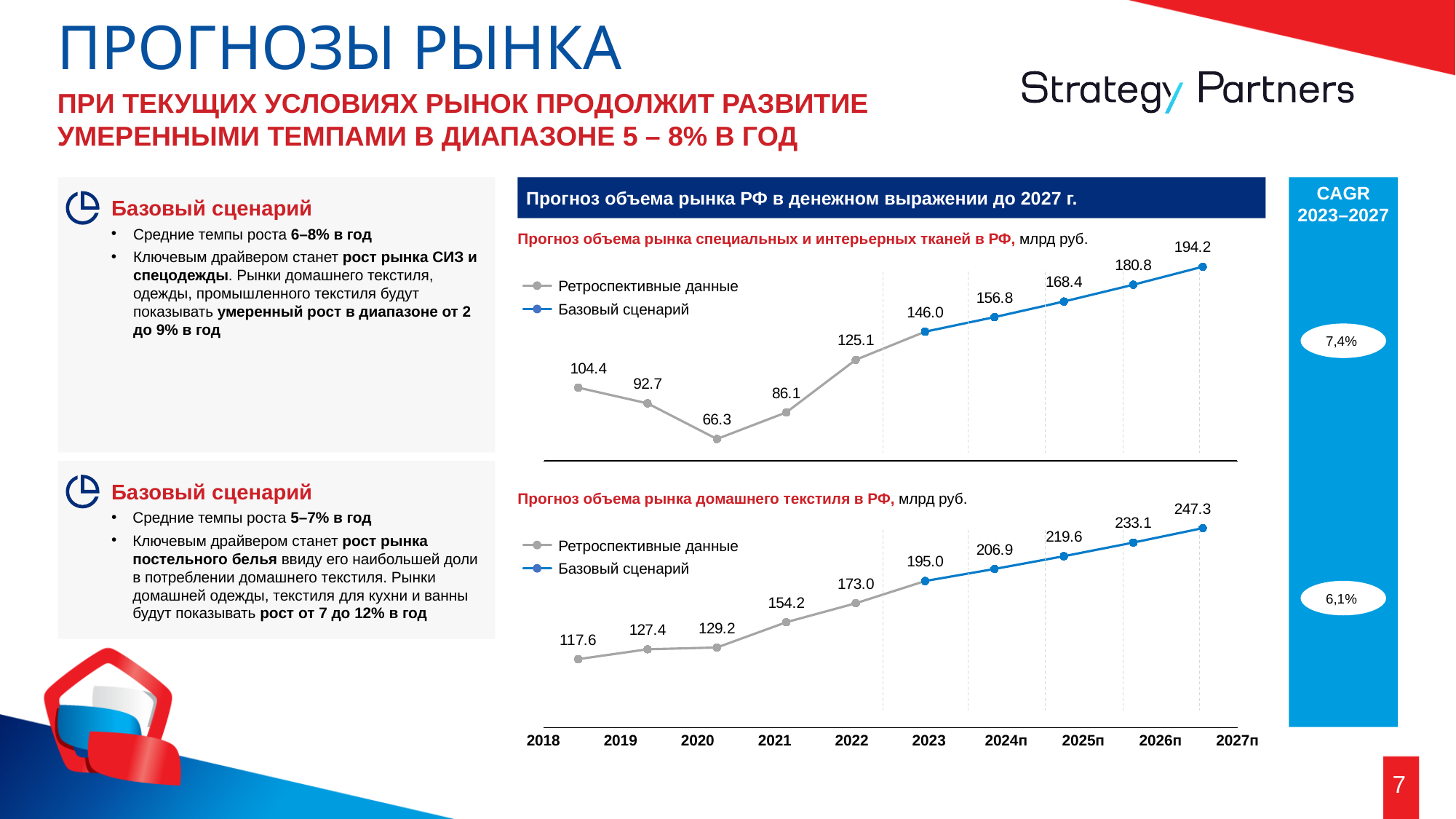
Which is larger: the 2022 value in the chart 'Прогноз объема рынка домашнего текстиля в РФ' or the 2022 value in the chart 'Прогноз объема рынка специальных и интерьерных тканей в РФ'? Домашнего текстиля (173.0) In the chart 'Прогноз объема рынка домашнего текстиля в РФ', what is the difference between the values for 2027п and 2023? 52.3 In the chart 'Прогноз объема рынка домашнего текстиля в РФ', which year has the highest value? 2027п What type of chart is 'Прогноз объема рынка домашнего текстиля в РФ'? Line chart In the chart 'Прогноз объема рынка специальных и интерьерных тканей в РФ', what is the difference between the values for 2023 and 2018? 41.6 In the chart 'Прогноз объема рынка домашнего текстиля в РФ', what is the value for 2021? 154.2 In the chart 'Прогноз объема рынка специальных и интерьерных тканей в РФ', what is the value for 2027п? 194.2 In the chart 'Прогноз объема рынка домашнего текстиля в РФ', what is the value for 2025п? 219.6 In the chart 'Прогноз объема рынка специальных и интерьерных тканей в РФ', which year has the lowest value? 2020 In the chart 'Прогноз объема рынка специальных и интерьерных тканей в РФ', what is the value for 2020? 66.3 In the chart 'Прогноз объема рынка домашнего текстиля в РФ', do the values rise or fall from 2018 to 2027п? rise In the chart 'Прогноз объема рынка специальных и интерьерных тканей в РФ', how many series does the legend list? 2